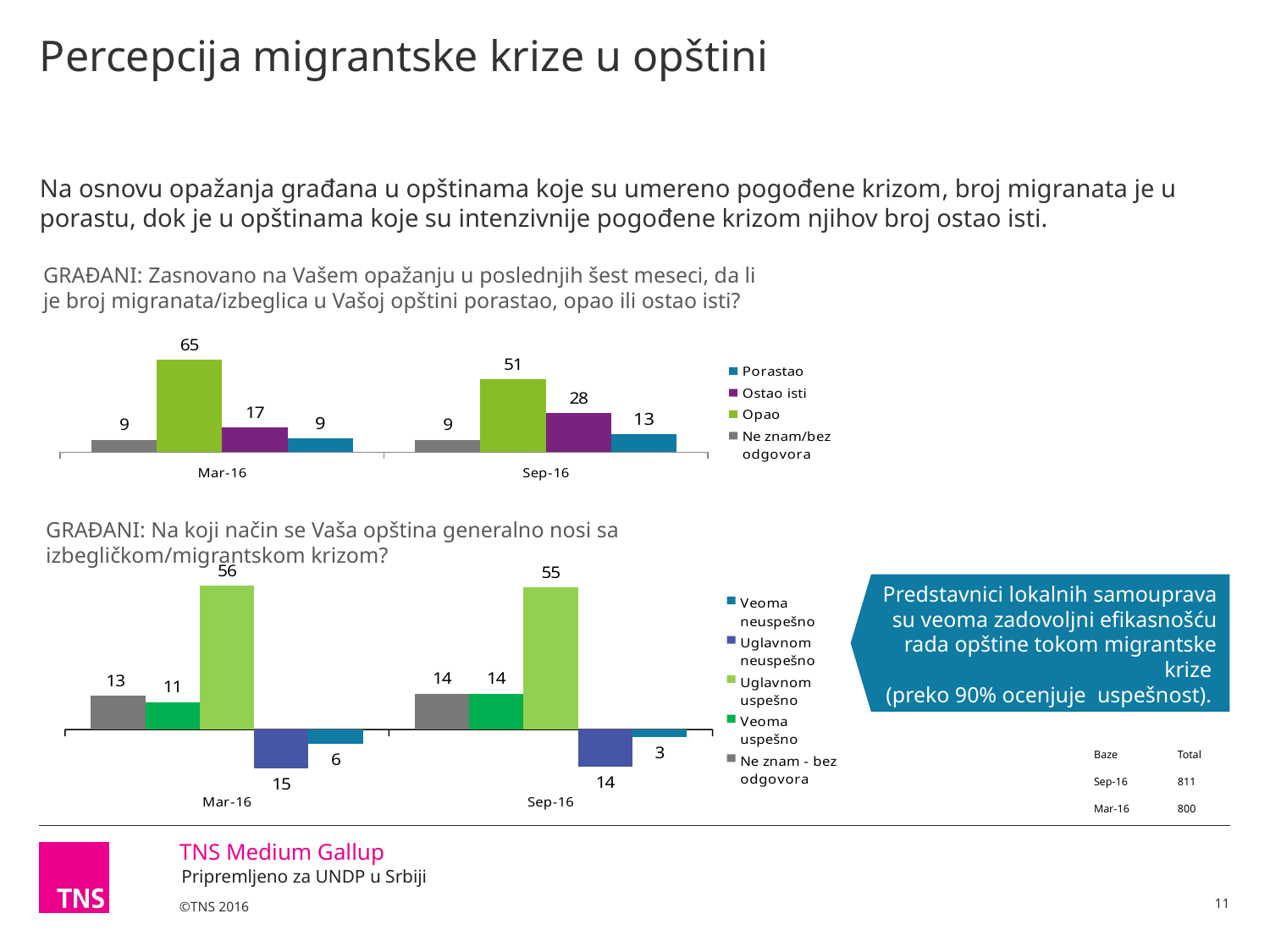
How many series does the legend of the bottom chart list? 5 In the top chart, what is the difference between the Porastao values for Sep-16 and Mar-16? 4 What kind of chart is the top chart (number of migrants increased, decreased or stayed the same)? bar chart In the bottom chart, what is the value for Uglavnom uspešno in Sep-16? 55 In the top chart, which series has the highest value in Sep-16? Opao In the top chart, what is the value for Opao in Mar-16? 65 In the top chart, by how much did the value for Ostao isti change from Mar-16 to Sep-16? 11 How many time periods are shown on the x axis of the bottom chart? 2 In the top chart, what is the value for Ostao isti in Sep-16? 28 How many series does the legend of the top chart list? 4 In the bottom chart, what is the value for Uglavnom neuspešno in Mar-16? 15 In the bottom chart, is the value for Veoma uspešno larger in Mar-16 or in Sep-16? Sep-16